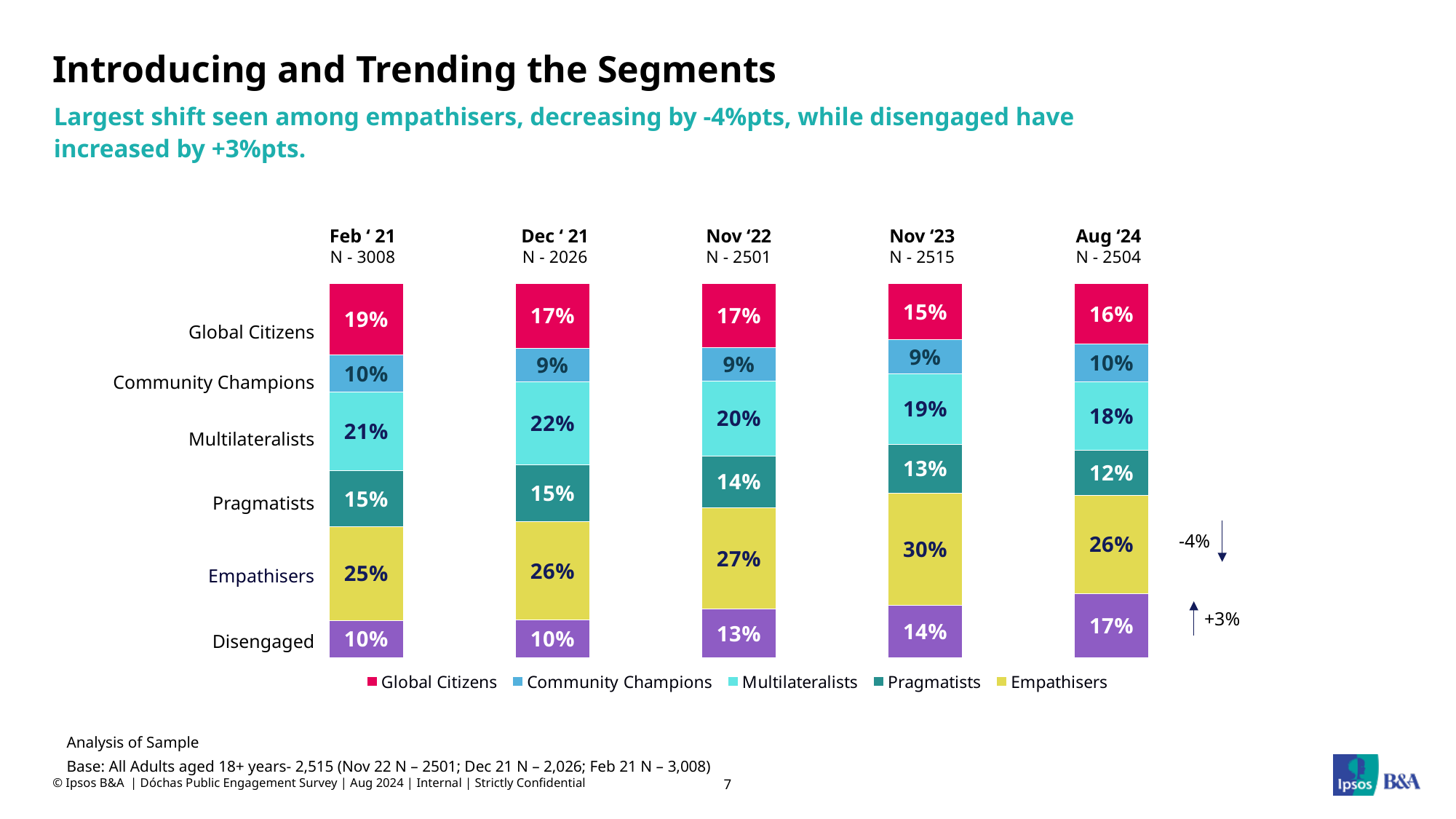
In which period is the Empathisers segment highest? Nov '23 Which is larger in Aug '24: Multilateralists or Pragmatists? Multilateralists What is the value for Empathisers in Nov '23? 30% Does the Disengaged segment rise or fall from Feb '21 to Aug '24? Rise What is the value for Disengaged in Aug '24? 17% What is the value for Global Citizens in Feb '21? 19% What is the difference between the Empathisers value in Nov '23 and in Aug '24? 4% How many series does the legend list? 5 How many time periods (bars) are shown in the chart? 5 In which period is the Global Citizens segment lowest? Nov '23 What kind of chart is shown on the slide? Stacked bar chart What is the value for Multilateralists in Dec '21? 22%